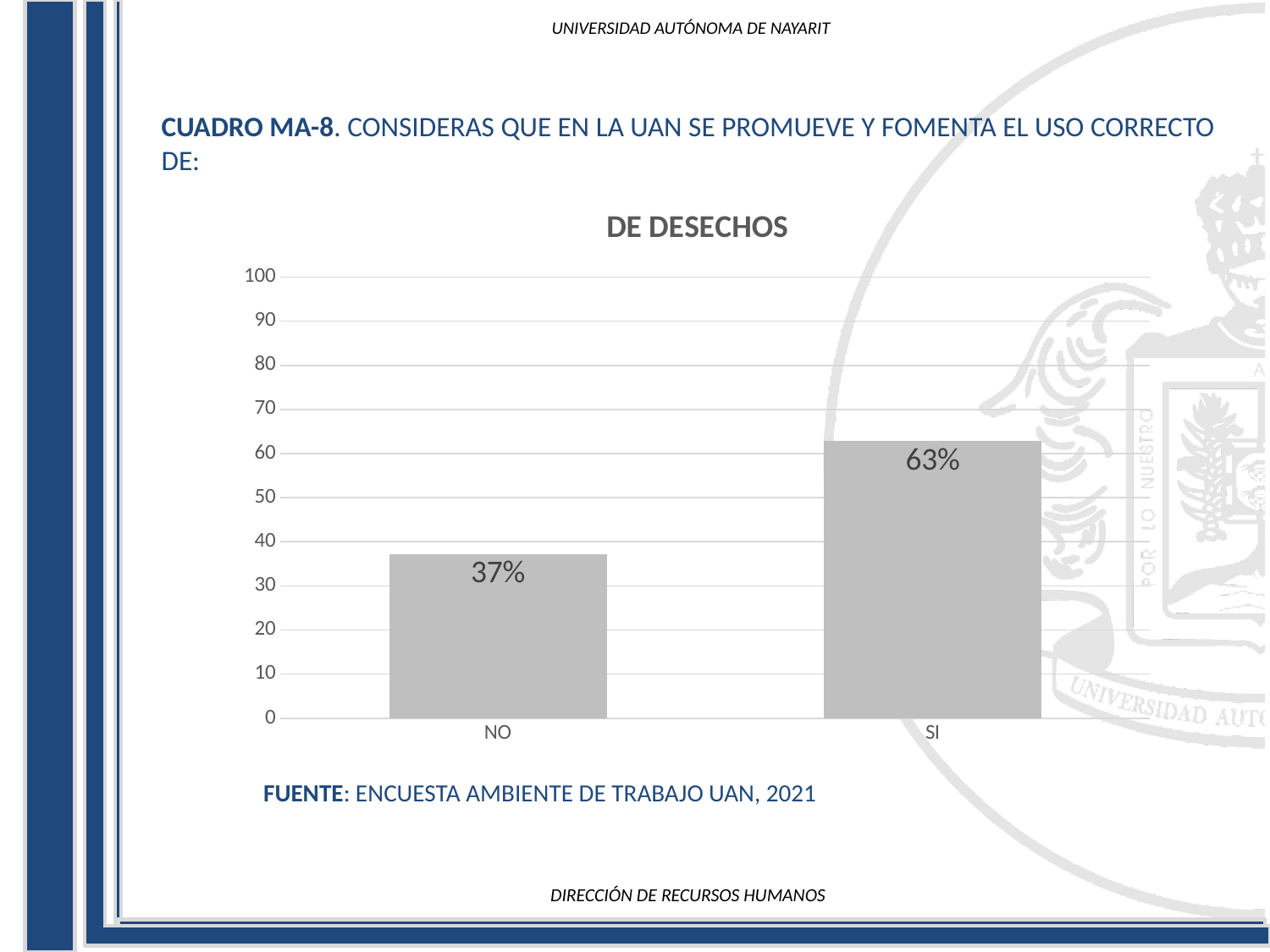
Is the value for NO greater or less than 40? less Which category has the highest value? SI What kind of chart is shown on the slide? bar chart What is the title of the chart? DE DESECHOS Which is larger, the value for NO or the value for SI? SI What is the value for SI? 63% Which category has the lowest value? NO What is the maximum value shown on the y axis? 100 What is the difference between the values for SI and NO? 26% How many categories are shown on the x axis? 2 What is the value for NO? 37% Is the value for SI greater or less than 50? greater